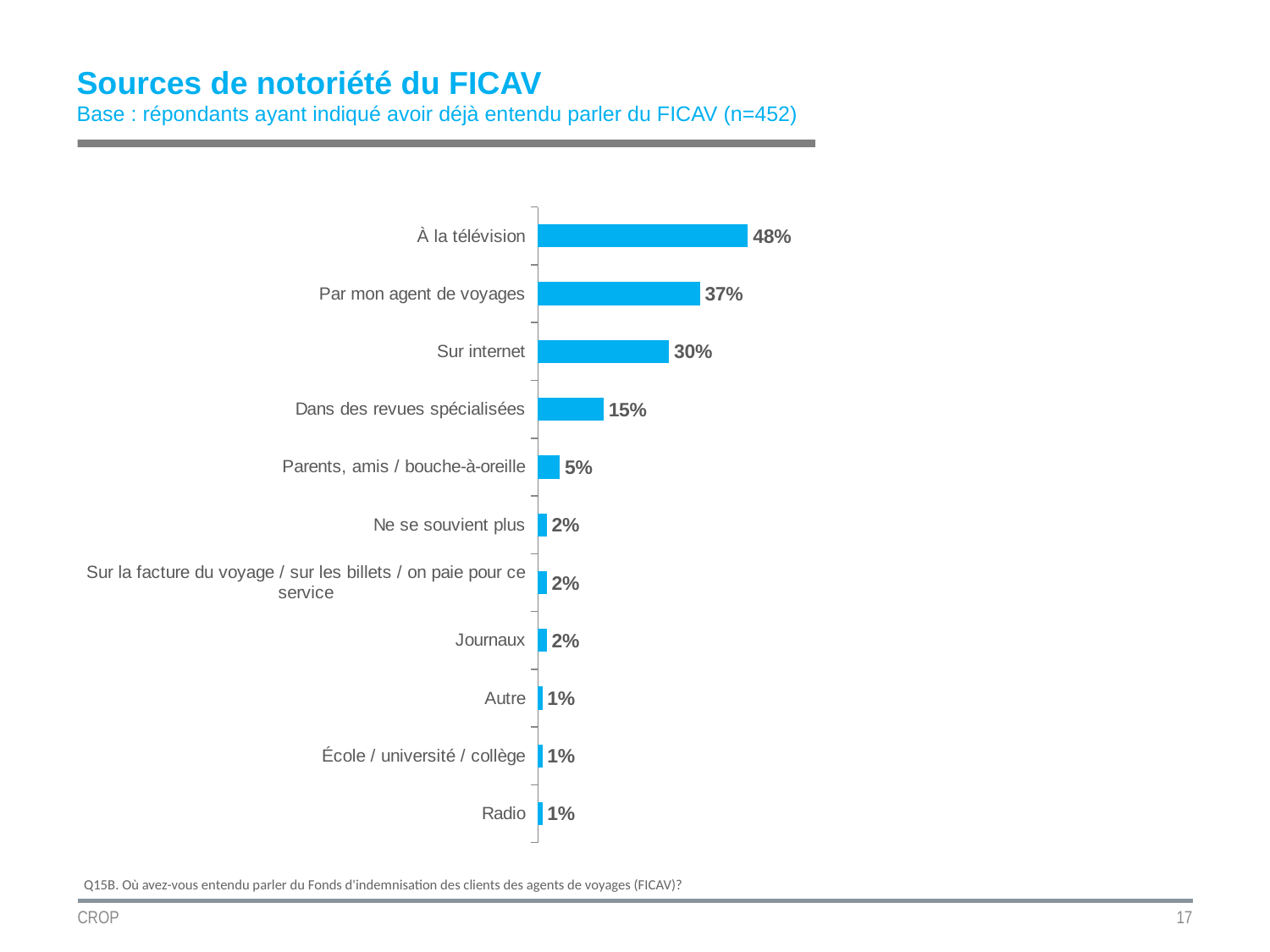
What is the value for "Dans des revues spécialisées"? 15% Which category has the highest value? À la télévision Which is larger, the value for "Sur internet" or the value for "Par mon agent de voyages"? Par mon agent de voyages What is the difference between the values for "À la télévision" and "Sur internet"? 18% What is the value for "Journaux"? 2% What is the value for "Par mon agent de voyages"? 37% What is the value for "Parents, amis / bouche-à-oreille"? 5% What is the difference between the values for "Par mon agent de voyages" and "Dans des revues spécialisées"? 22% What kind of chart is shown on the slide? Bar chart What is the value for "À la télévision"? 48% How many categories are shown in the chart? 11 What is the title of the slide? Sources de notoriété du FICAV